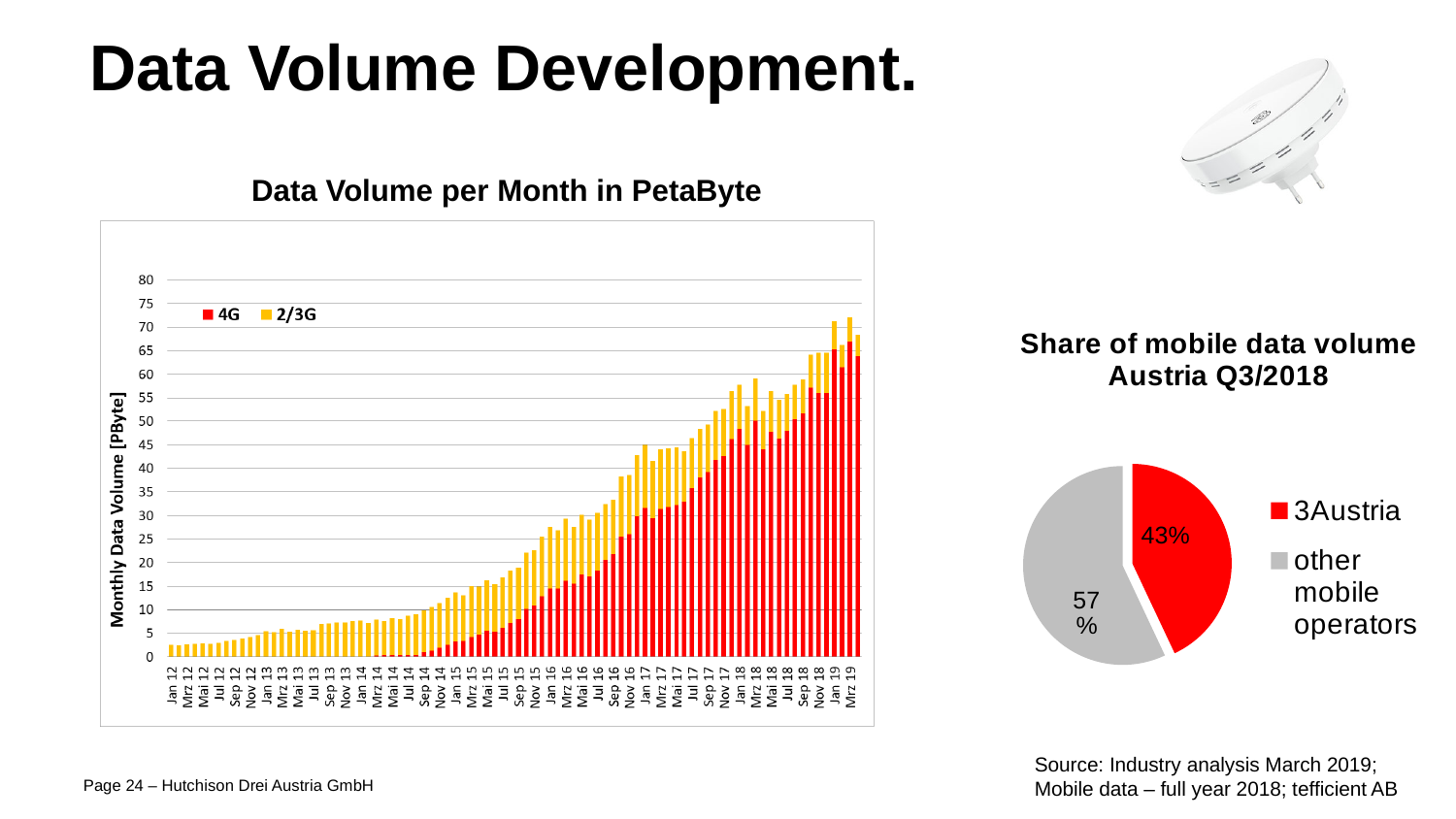
On the 'Data Volume per Month in PetaByte' chart, how many series does the legend list? 2 On the 'Share of mobile data volume Austria Q3/2018' chart, what is the difference between the share of other mobile operators and the share of 3Austria? 14% On the 'Share of mobile data volume Austria Q3/2018' chart, what share does 3Austria have? 43% On the 'Data Volume per Month in PetaByte' chart, what kind of chart is it? bar chart On the 'Data Volume per Month in PetaByte' chart, is the total value for Jan 16 greater or less than 20? greater On the 'Data Volume per Month in PetaByte' chart, which two series are shown in the legend? 4G and 2/3G On the 'Data Volume per Month in PetaByte' chart, do the monthly data volumes rise or fall from Jan 12 to Mrz 19? rise On the 'Share of mobile data volume Austria Q3/2018' chart, which slice is larger, 3Austria or other mobile operators? other mobile operators On the 'Data Volume per Month in PetaByte' chart, is the total value for Mrz 19 greater or less than 60? greater On the 'Share of mobile data volume Austria Q3/2018' chart, what share do other mobile operators have? 57% On the 'Data Volume per Month in PetaByte' chart, is the total value for Jan 12 greater or less than 5? less On the 'Data Volume per Month in PetaByte' chart, what is the label of the vertical axis? Monthly Data Volume [PByte]